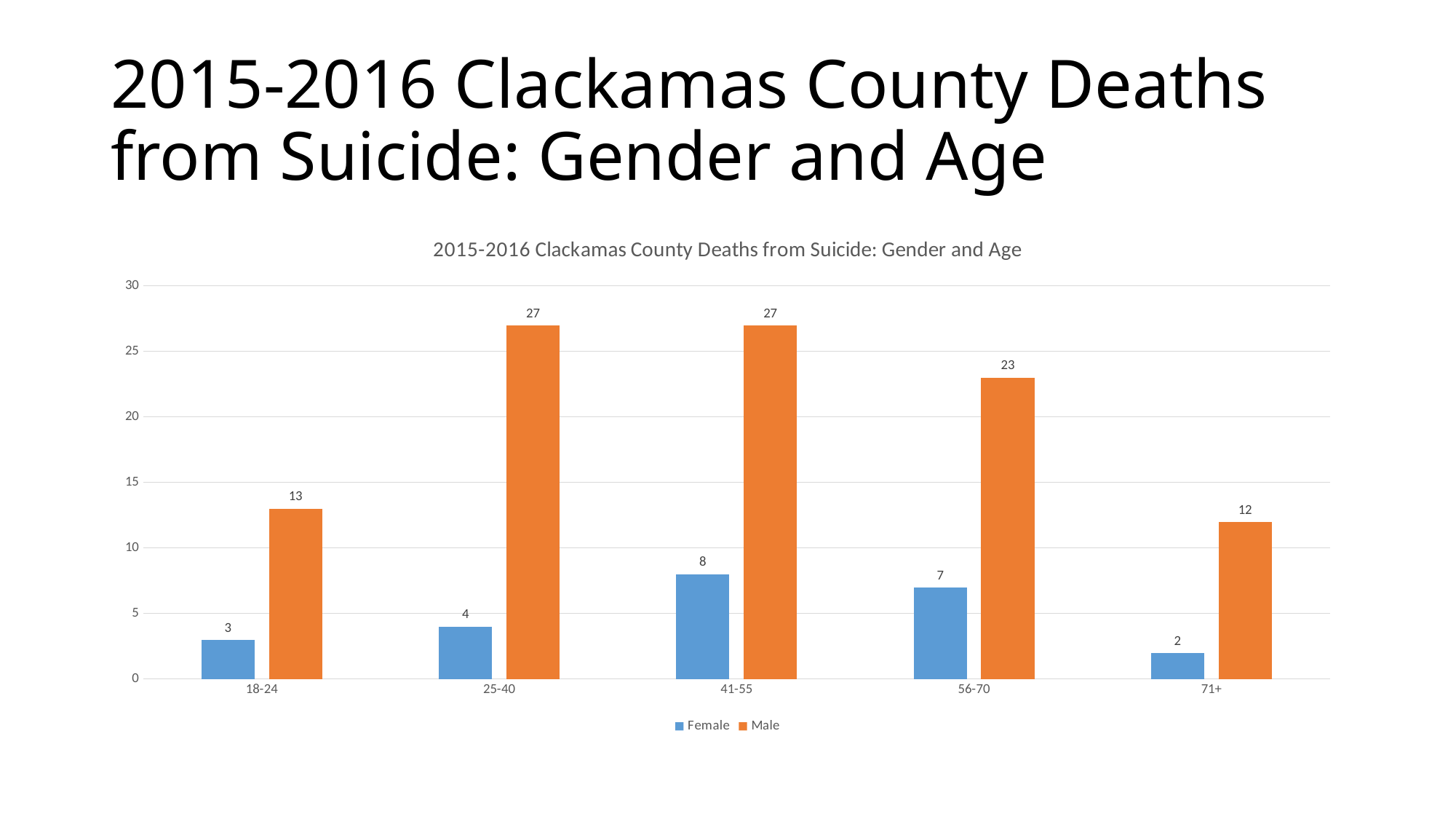
How many age groups are shown on the x axis? 5 Which age group has the highest Female value? 41-55 What is the Male value for the 41-55 age group? 27 What is the difference between the Male values for 56-70 and 18-24? 10 Which age group has the lowest Male value? 71+ Which is larger, the Female value for 18-24 or the Female value for 25-40? 25-40 What is the difference between the Male and Female values for the 25-40 age group? 23 What is the Female value for the 56-70 age group? 7 How many series does the legend list? 2 What is the Male value for the 71+ age group? 12 Which age group has the lowest Female value? 71+ What kind of chart is shown on the slide? bar chart